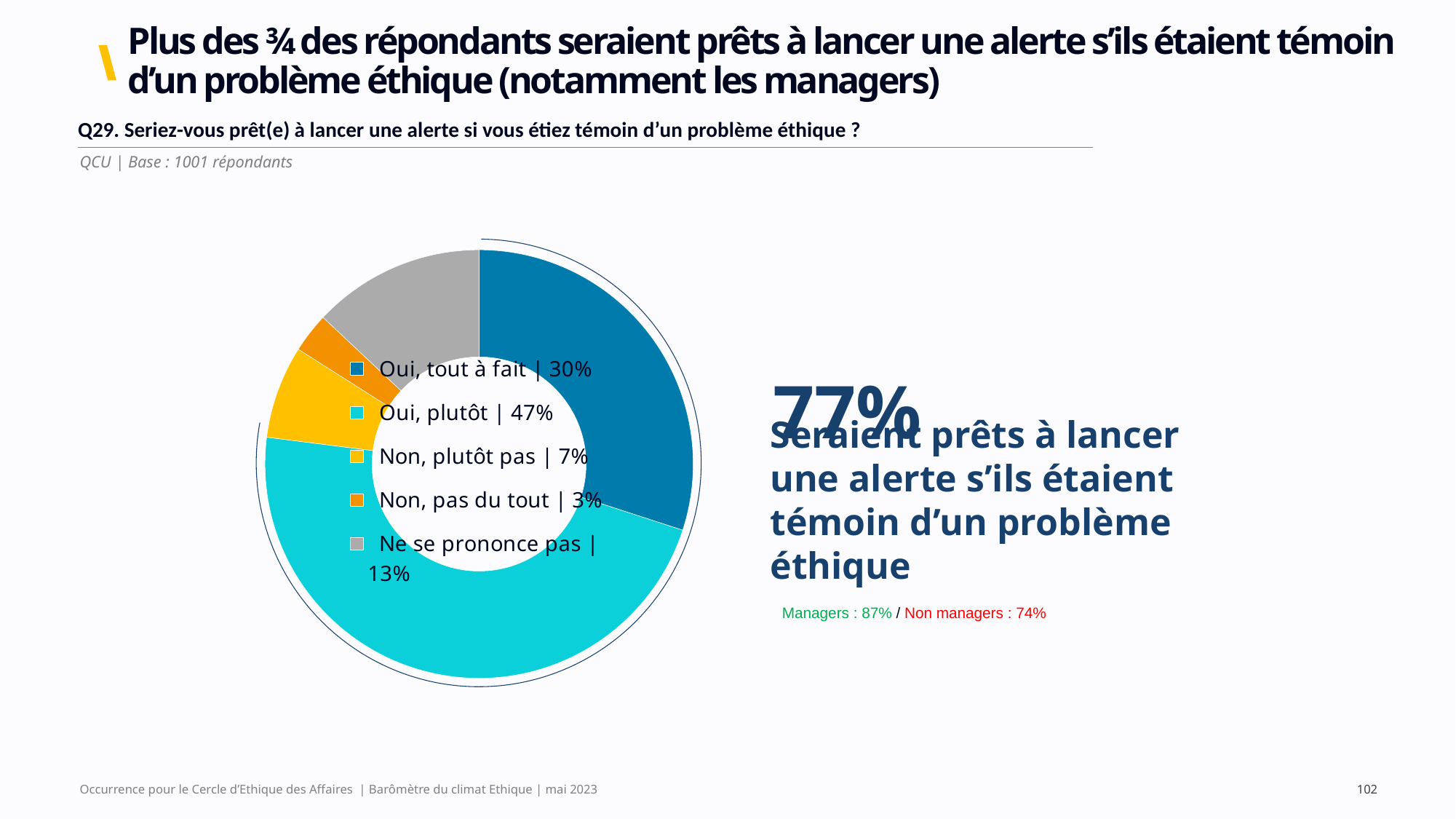
What is the combined share of the two "Oui" responses? 77% What is the difference in percentage points between "Oui, plutôt" and "Oui, tout à fait"? 17 What kind of chart is shown on the slide? Pie chart (donut) What colour is the "Non, plutôt pas" slice? Yellow What percentage of respondents answered "Oui, tout à fait"? 30% What percentage of respondents answered "Ne se prononce pas"? 13% What percentage of respondents answered "Oui, plutôt"? 47% Which is larger: the share for "Non, plutôt pas" or the share for "Ne se prononce pas"? Ne se prononce pas How many response categories does the chart show? 5 What percentage of respondents answered "Non, pas du tout"? 3% Which response category has the largest share of the pie? Oui, plutôt Which response category has the smallest share of the pie? Non, pas du tout